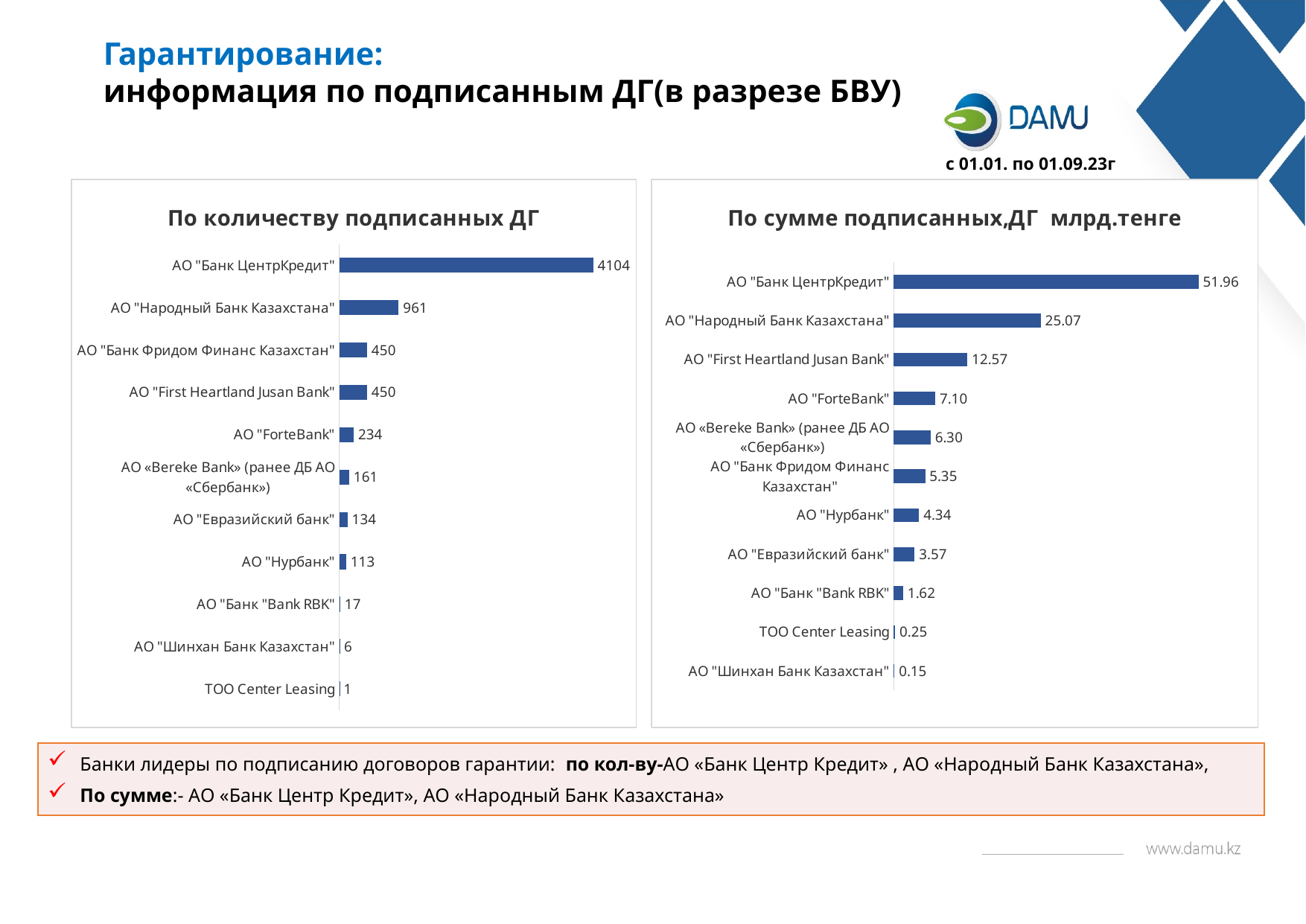
In the chart "По количеству подписанных ДГ", how many banks are listed? 11 What is the title of the right chart on the slide? По сумме подписанных,ДГ млрд.тенге In the chart "По количеству подписанных ДГ", what is the value for АО "ForteBank"? 234 What type of chart is the left chart "По количеству подписанных ДГ"? Bar chart In the chart "По сумме подписанных ДГ млрд.тенге", which is larger: АО "ForteBank" or АО "Евразийский банк"? АО "ForteBank" In the chart "По количеству подписанных ДГ", what is the value for АО "Банк ЦентрКредит"? 4104 In the chart "По количеству подписанных ДГ", what is the difference between АО "Народный Банк Казахстана" and АО "First Heartland Jusan Bank"? 511 In the chart "По сумме подписанных ДГ млрд.тенге", what is the difference between АО "Банк ЦентрКредит" and АО "Народный Банк Казахстана"? 26.89 In the chart "По сумме подписанных ДГ млрд.тенге", which bank has the highest value? АО "Банк ЦентрКредит" In the chart "По количеству подписанных ДГ", which bank has the lowest value? ТОО Center Leasing In the chart "По сумме подписанных ДГ млрд.тенге", what is the value for АО "Народный Банк Казахстана"? 25.07 In the chart "По сумме подписанных ДГ млрд.тенге", what is the value for АО "Нурбанк"? 4.34